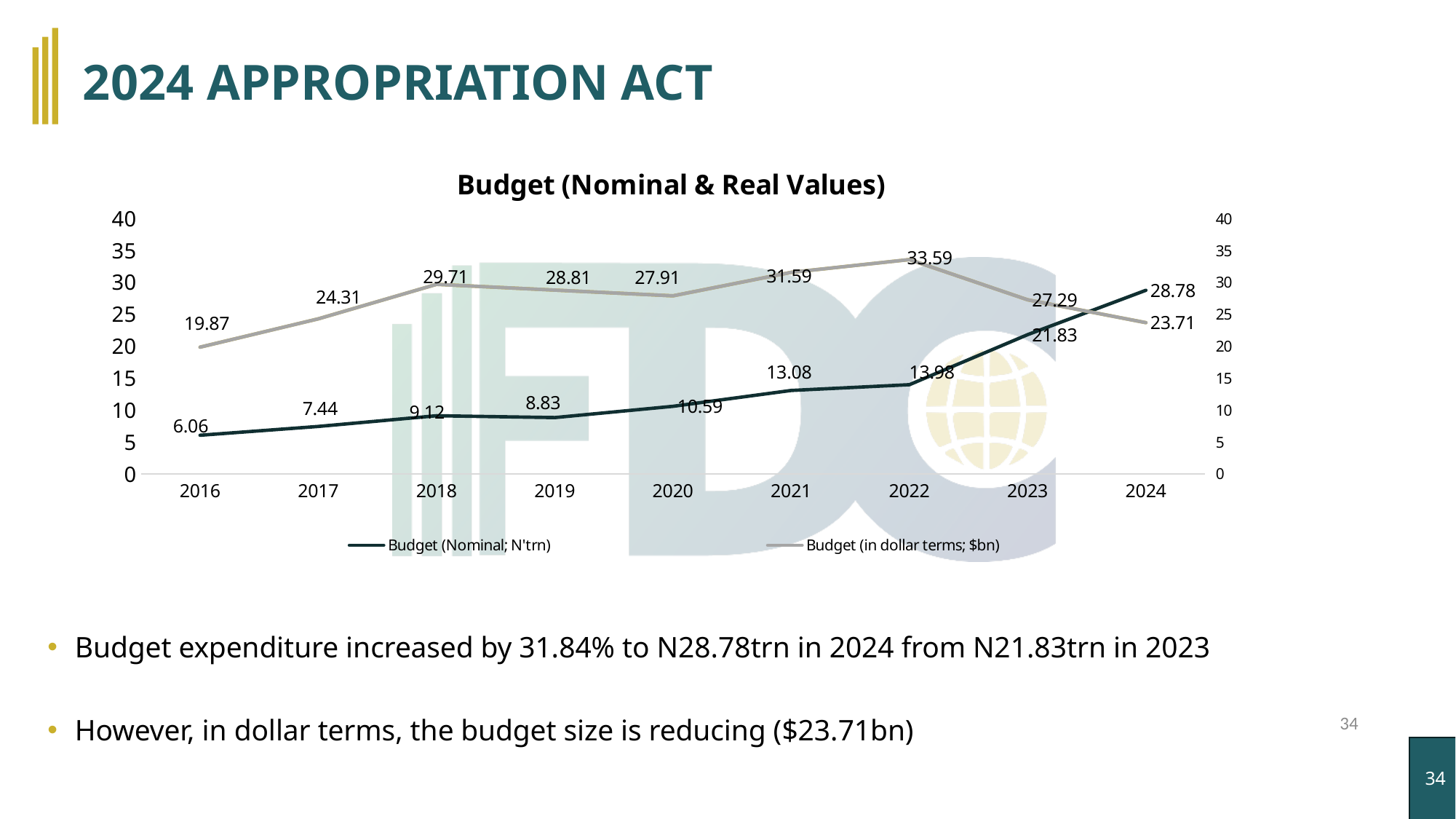
Does Budget (in dollar terms; $bn) rise or fall from 2022 to 2024? Fall What is the title of the chart? Budget (Nominal & Real Values) In which year is Budget (Nominal; N'trn) lowest? 2016 What is the value of Budget (Nominal; N'trn) for 2020? 10.59 What is the difference between Budget (Nominal; N'trn) in 2024 and in 2023? 6.95 How many series does the legend list? 2 What type of chart is shown on the slide? Line chart What is the value of Budget (in dollar terms; $bn) for 2016? 19.87 How many years are plotted on the x axis? 9 What is the value of Budget (Nominal; N'trn) for 2024? 28.78 In which year is Budget (in dollar terms; $bn) highest? 2022 Which is larger in 2024: Budget (Nominal; N'trn) or Budget (in dollar terms; $bn)? Budget (Nominal; N'trn)